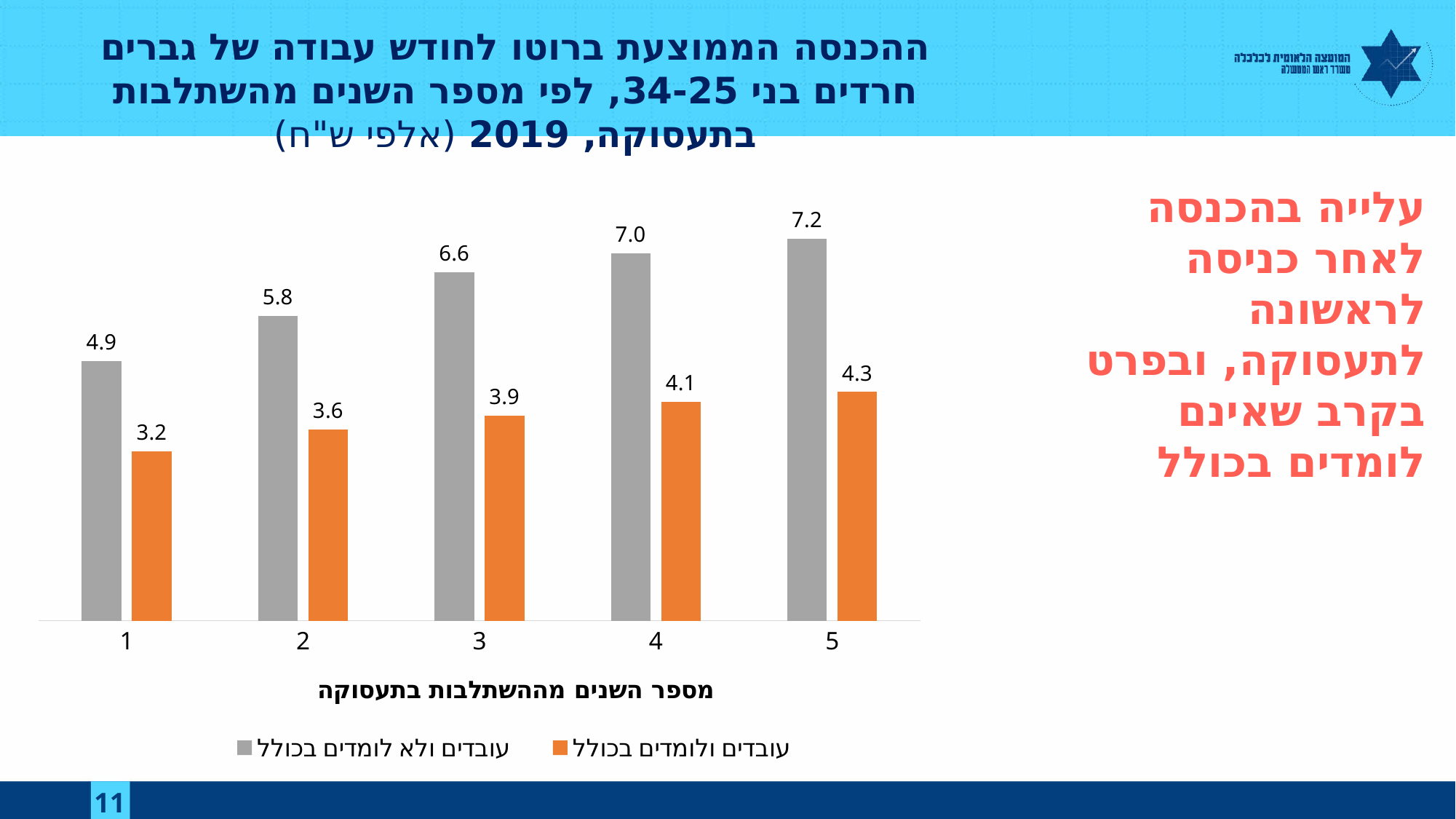
How many categories are shown on the x axis? 5 What is the value for category 1 in the orange series (עובדים ולומדים בכולל)? 3.2 What is the value for category 3 in the gray series (עובדים ולא לומדים בכולל)? 6.6 What kind of chart is shown on the slide? bar chart What is the difference between the gray and orange bars for category 4? 2.9 Do the values of the orange series (עובדים ולומדים בכולל) rise or fall from category 1 to category 5? rise What is the value for category 5 in the orange series (עובדים ולומדים בכולל)? 4.3 What is the difference between the gray series values for category 5 and category 1? 2.3 Which category has the lowest value in the orange series (עובדים ולומדים בכולל)? 1 How many series does the legend list? 2 Which category has the highest value in the gray series (עובדים ולא לומדים בכולל)? 5 Which is larger for category 2: the gray bar (עובדים ולא לומדים בכולל) or the orange bar (עובדים ולומדים בכולל)? the gray bar (עובדים ולא לומדים בכולל)